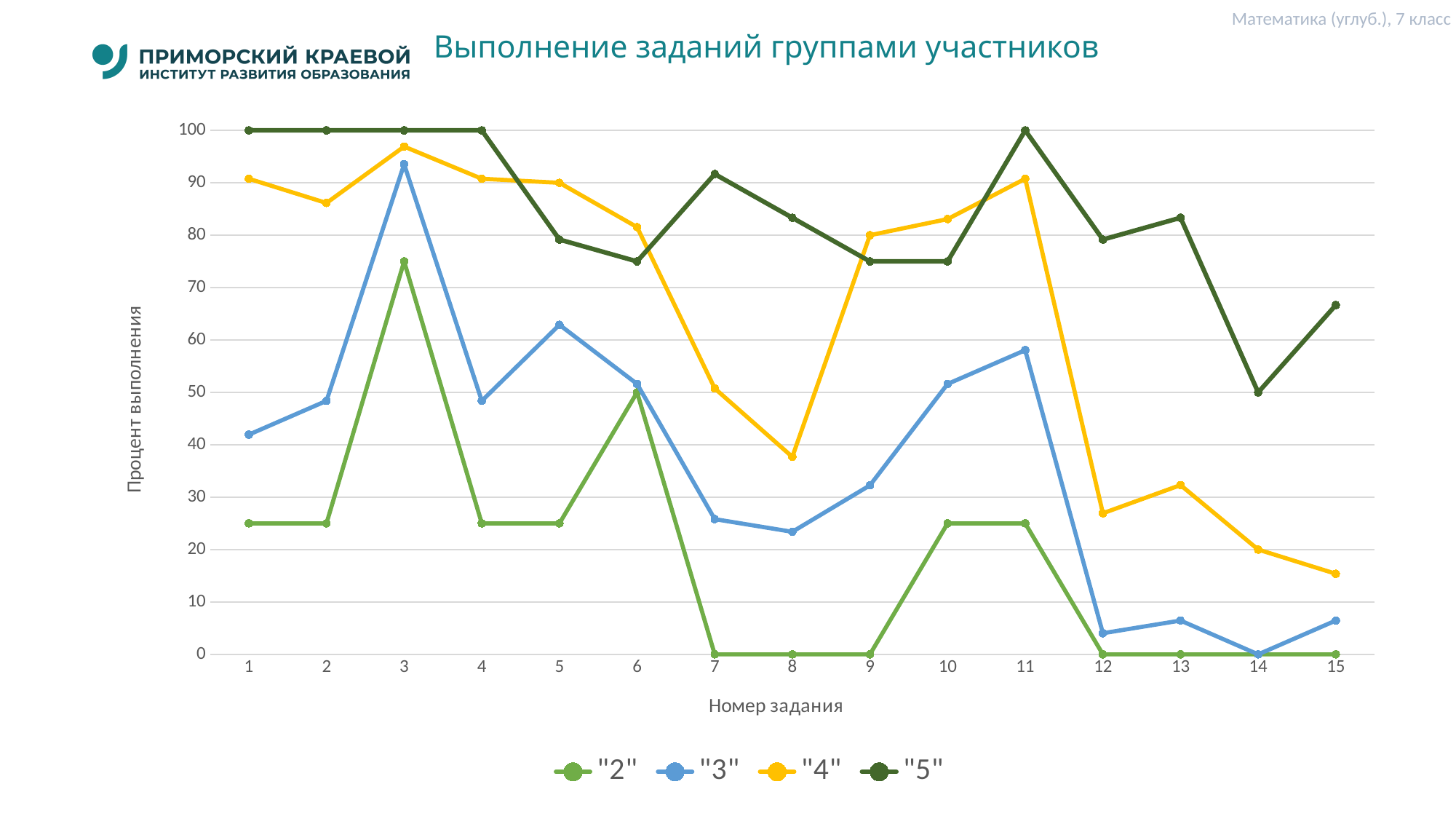
What is the value for series "5" at task 1? 100 For series "5", at which task number is the value lowest? 14 Is the value for series "3" at task 3 greater or less than 90? greater How many task numbers are plotted along the x axis? 15 At task 7, which series has the larger value, "5" or "4"? "5" How many series does the legend list? 4 For series "4", at which task number is the value highest? 3 What kind of chart is shown on the slide? line chart What is the value for series "2" at task 8? 0 Is the value for series "4" at task 8 greater or less than 40? less What is the value for series "3" at task 14? 0 What is the title of the vertical axis? Процент выполнения